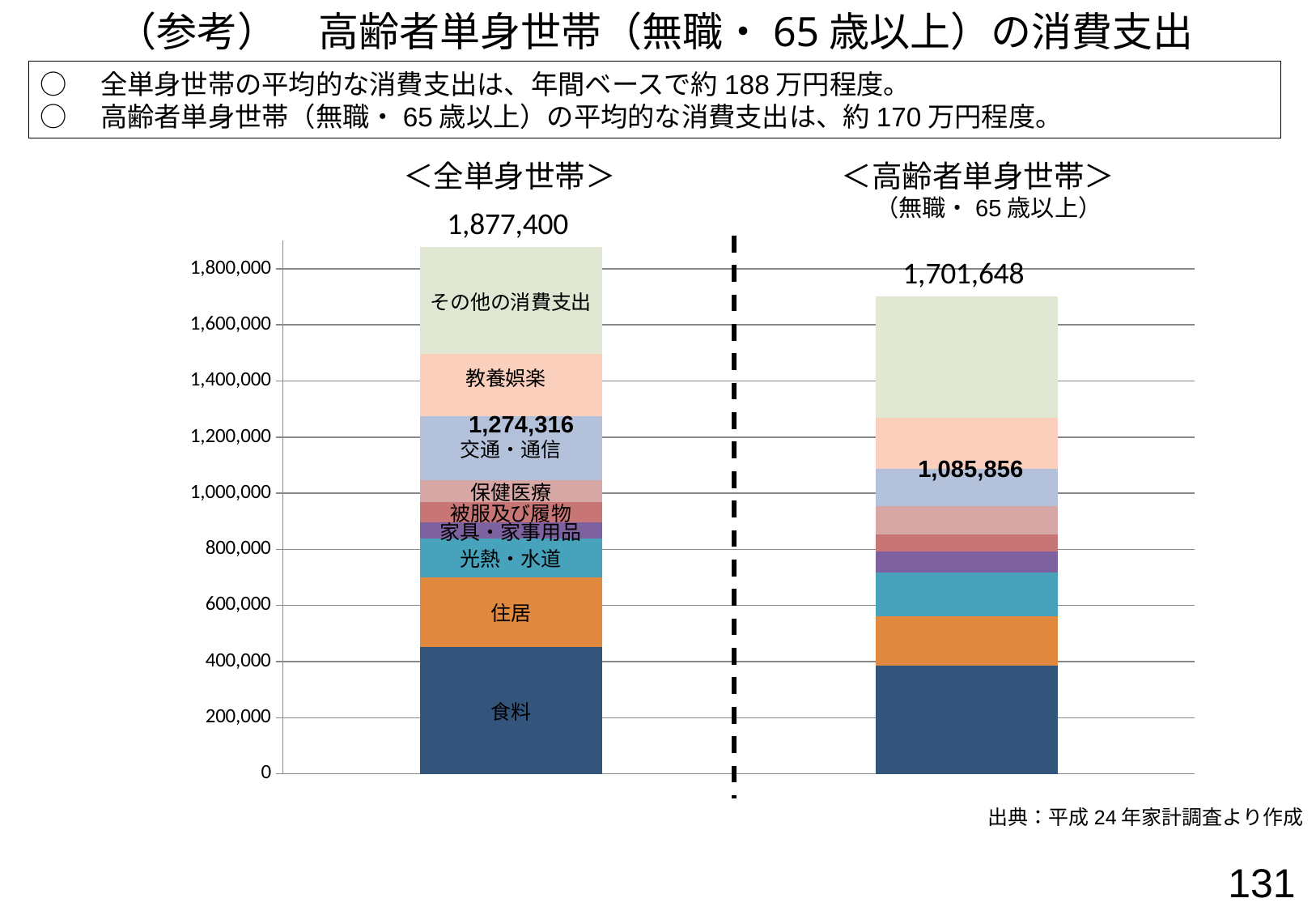
What value is labelled at the top of the 交通・通信 segment in the 高齢者単身世帯 bar? 1,085,856 What is the difference between the labelled values 1,274,316 (全単身世帯) and 1,085,856 (高齢者単身世帯)? 188,460 Which bar has the larger total, 全単身世帯 or 高齢者単身世帯（無職・65歳以上）? 全単身世帯 Which expenditure category is the bottom segment of each stacked bar? 食料 What is the difference between the totals of the 全単身世帯 bar and the 高齢者単身世帯 bar? 175,752 How many stacked bars are plotted in the chart? 2 What is the total consumption expenditure shown above the 全単身世帯 bar? 1,877,400 How many expenditure categories (segments) make up each stacked bar? 9 What is the total consumption expenditure shown above the 高齢者単身世帯（無職・65歳以上） bar? 1,701,648 Is the 食料 segment of the 全単身世帯 bar greater or less than 400,000? greater What value is labelled at the top of the 交通・通信 segment in the 全単身世帯 bar? 1,274,316 What kind of chart is shown on the slide? Stacked bar chart